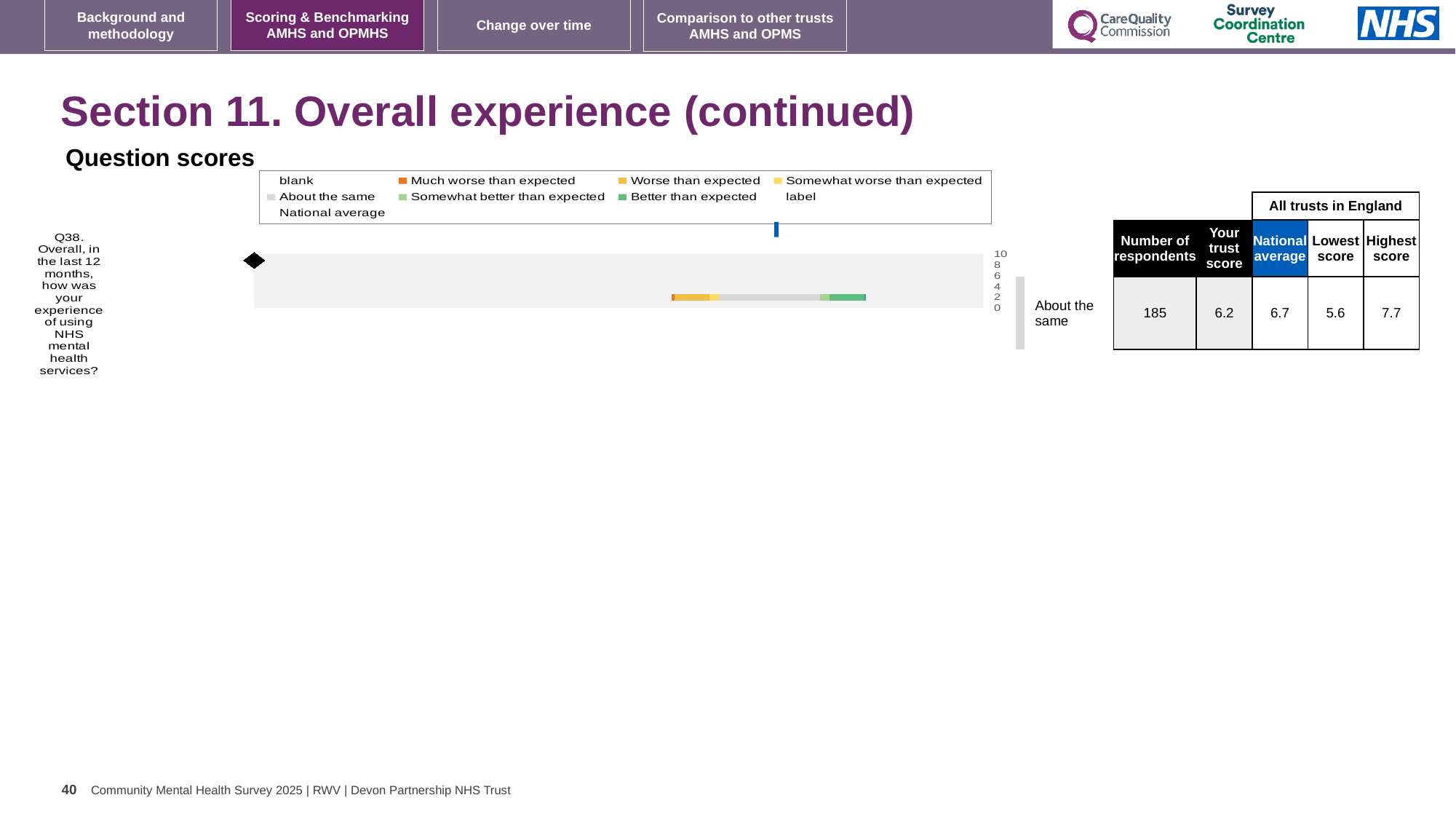
What category label is shown next to the bar for Q38? About the same How many entries does the legend of the 'Question scores' chart list? 9 What is the difference between the highest score and the lowest score for Q38 in the table beside the chart? 2.1 What is the national average for Q38 shown in the table beside the chart? 6.7 How many respondents answered Q38 according to the table beside the chart? 185 Which is larger for Q38: the trust score or the national average? National average What is the highest score among all trusts in England for Q38? 7.7 Which question is plotted in the 'Question scores' chart? Q38. Overall, in the last 12 months, how was your experience of using NHS mental health services? What is the trust score for Q38 shown in the table beside the chart? 6.2 What is the difference between the national average and the trust score for Q38? 0.5 How many questions are plotted in the 'Question scores' chart? 1 What kind of chart is shown under 'Question scores'? bar chart